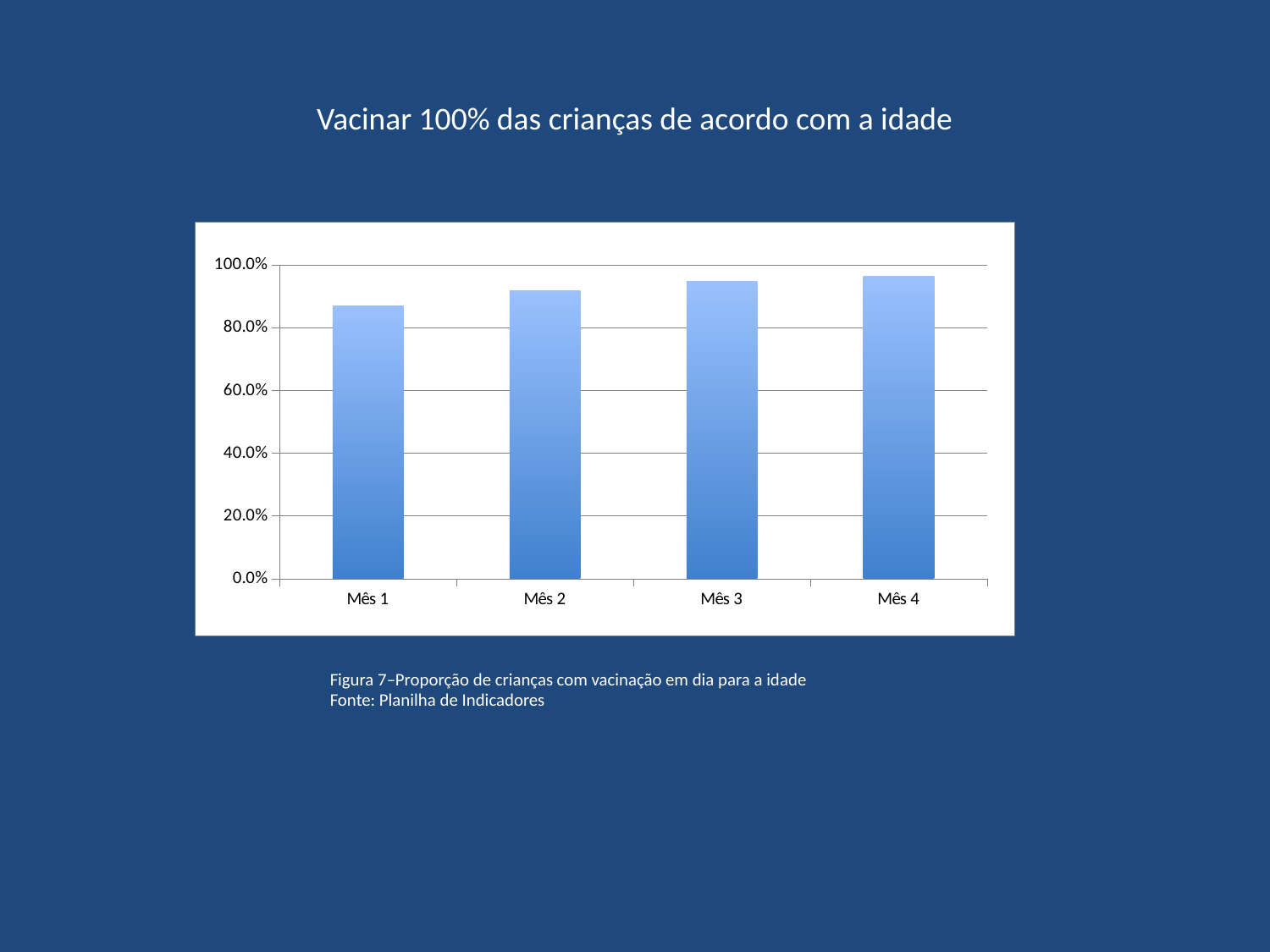
Do the values rise or fall from Mês 1 to Mês 4? Rise How many months (categories) are shown on the x axis of the chart? 4 Which month has the lowest bar in the chart? Mês 1 What is the title shown above the chart on the slide? Vacinar 100% das crianças de acordo com a idade Is the value for Mês 2 greater or less than 100.0%? less Is the value for Mês 3 greater or less than 80.0%? greater Which is larger, the value for Mês 1 or the value for Mês 4? Mês 4 Is the value for Mês 1 greater or less than 80.0%? greater Which is larger, the value for Mês 1 or the value for Mês 2? Mês 2 What source is cited below the chart? Planilha de Indicadores What kind of chart is shown on the slide? Bar chart